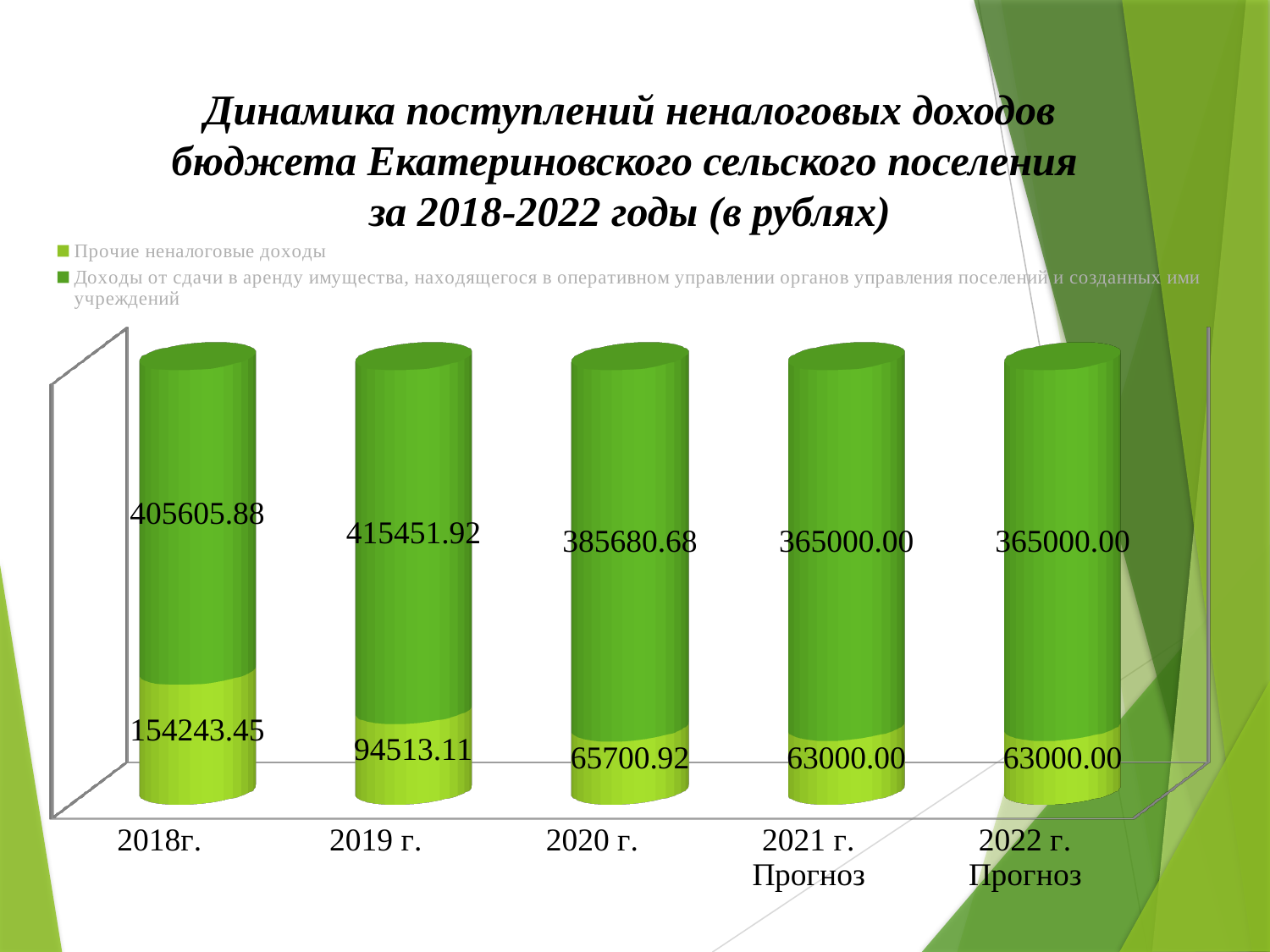
How many series does the legend list? 2 What is the value for Доходы от сдачи в аренду имущества in 2021 г. Прогноз? 365000.00 What is the value for Доходы от сдачи в аренду имущества in 2019 г.? 415451.92 Which is larger: Прочие неналоговые доходы in 2018г. or in 2019 г.? 2018г. In which year is the value for Доходы от сдачи в аренду имущества the highest? 2019 г. What is the value for Прочие неналоговые доходы in 2020 г.? 65700.92 What kind of chart is shown on the slide? Stacked bar chart What is the value for Прочие неналоговые доходы in 2018г.? 154243.45 How many years are shown on the x axis? 5 In which year is the value for Прочие неналоговые доходы the highest? 2018г. What is the difference between the Доходы от сдачи в аренду имущества values for 2019 г. and 2018г.? 9846.04 What is the total of the stacked bar for 2021 г. Прогноз? 428000.00